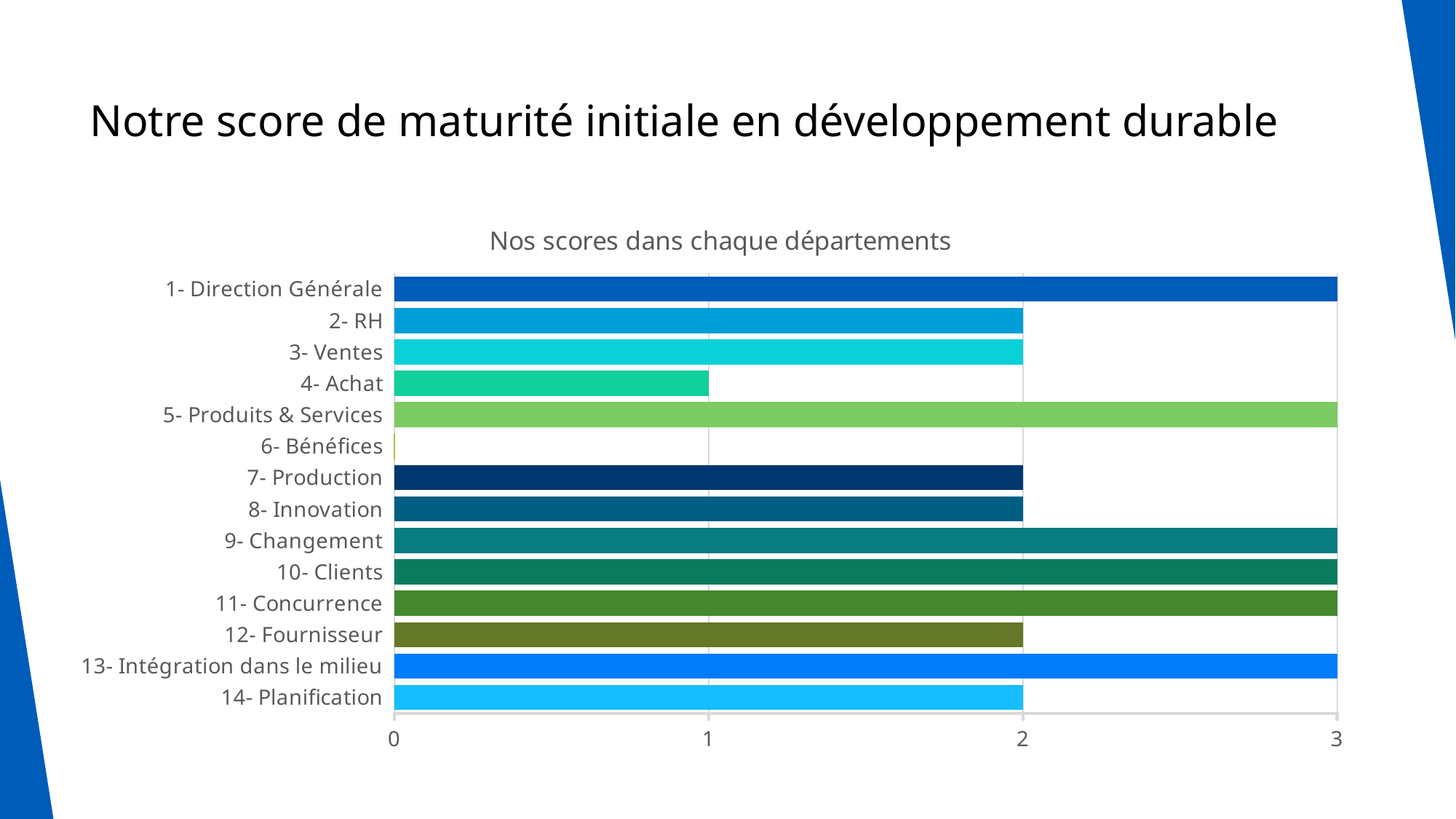
What is the score for 12- Fournisseur? 2 Which department has the lowest score? 6- Bénéfices Which is larger, the score for 2- RH or the score for 4- Achat? 2- RH What is the score for 4- Achat? 1 What type of chart is shown on the slide? bar chart How many departments are listed on the chart? 14 What is the title of the chart? Nos scores dans chaque départements What is the difference between the score for 9- Changement and the score for 8- Innovation? 1 What is the score for 1- Direction Générale? 3 What is the difference between the score for 13- Intégration dans le milieu and the score for 4- Achat? 2 Is the score for 5- Produits & Services greater or less than 2? greater What is the score for 14- Planification? 2